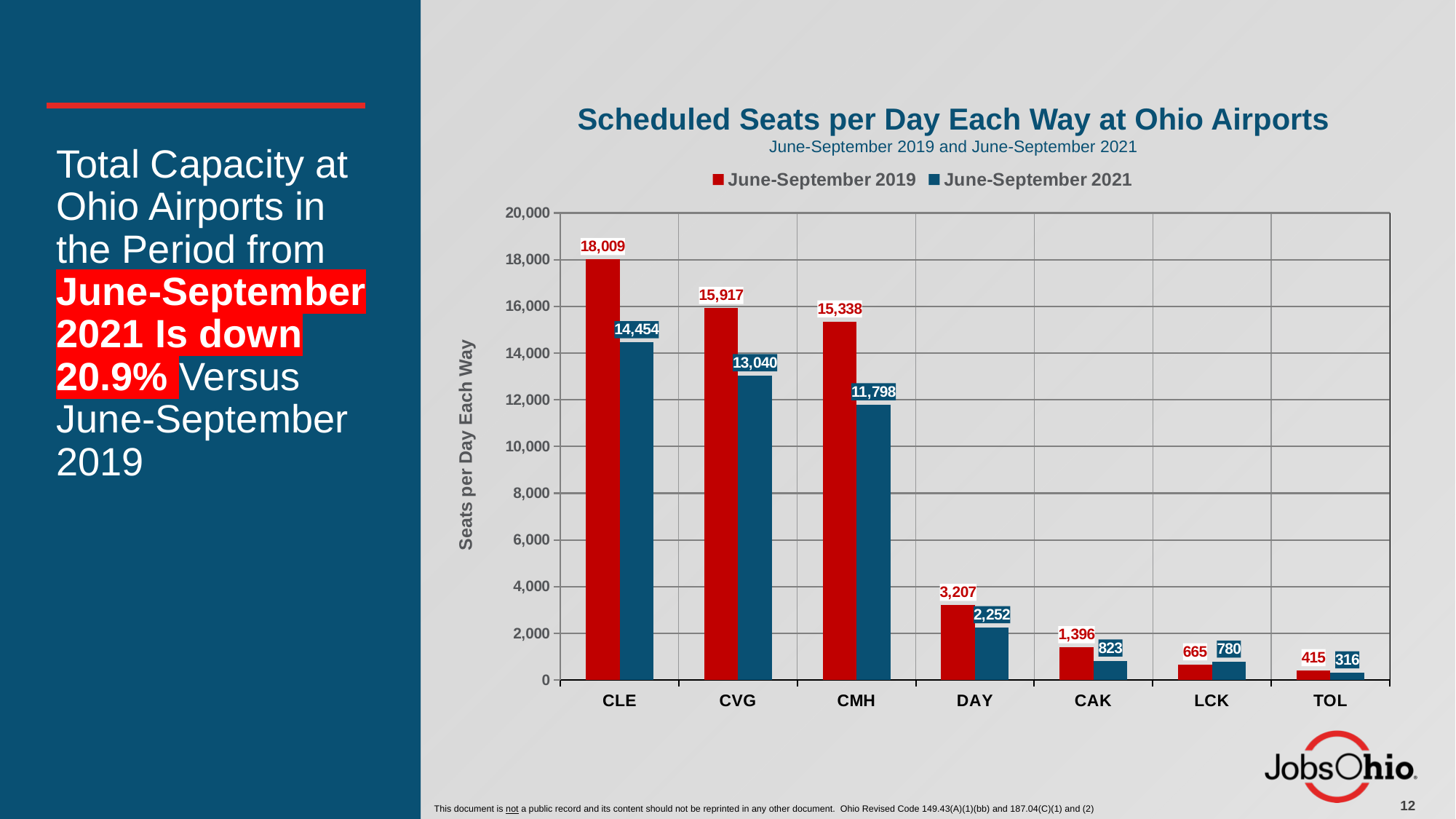
What is the title of the chart? Scheduled Seats per Day Each Way at Ohio Airports What is the June-September 2021 value for CVG? 13,040 What kind of chart is shown on the slide? Bar chart Which airport has the highest June-September 2019 value? CLE What is the June-September 2021 value for DAY? 2,252 Is the June-September 2021 value for CLE greater or less than 14,000? greater How many series does the legend list? 2 Which airport has the lowest June-September 2021 value? TOL What is the June-September 2019 value for CLE? 18,009 For LCK, which is larger: the June-September 2019 value or the June-September 2021 value? June-September 2021 How many airports are shown on the x axis? 7 What is the difference between the June-September 2019 and June-September 2021 values for CMH? 3,540